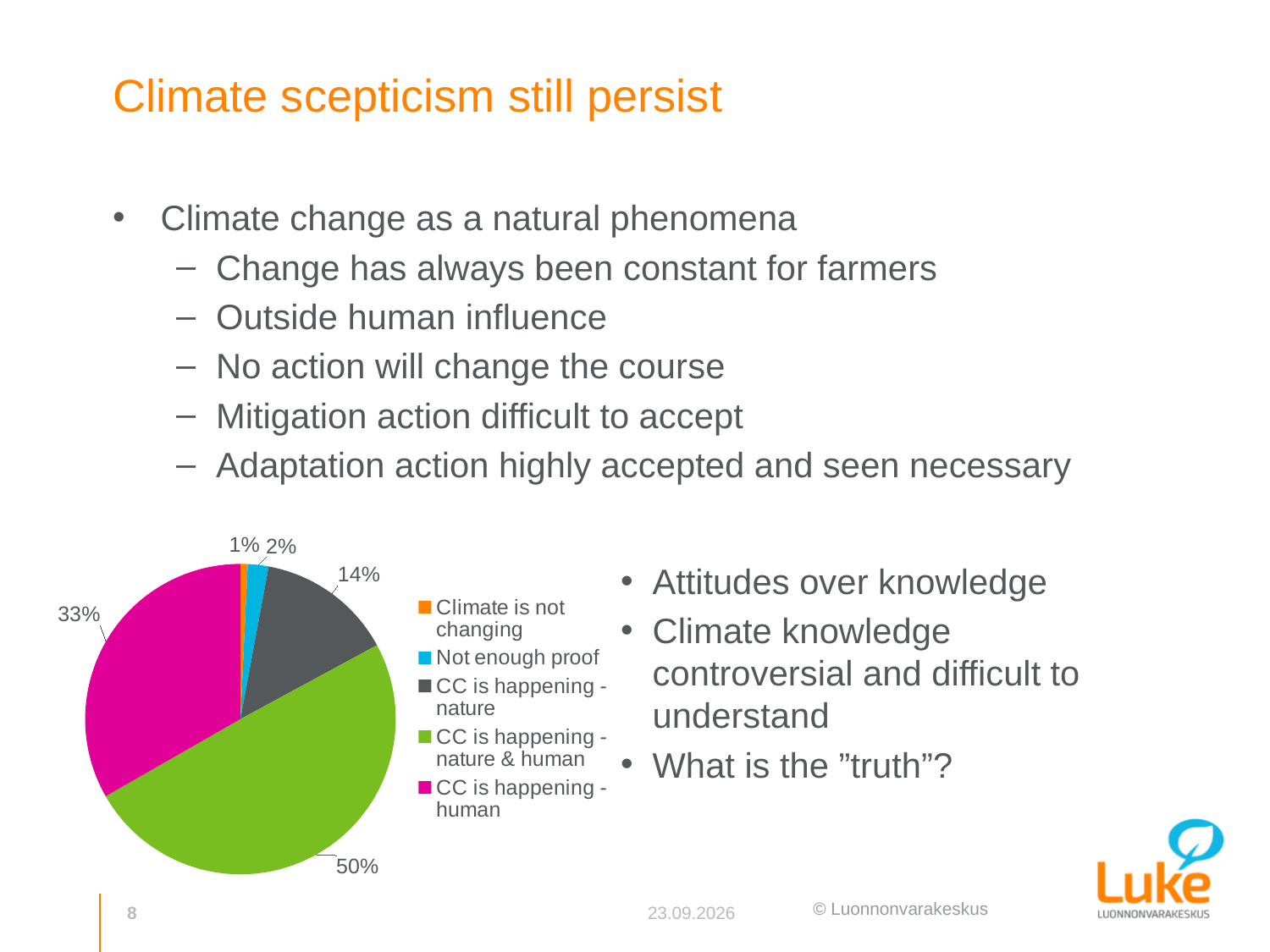
What percentage of the pie is 'CC is happening - human'? 33% What percentage of the pie is 'Climate is not changing'? 1% Which is larger: the share for 'CC is happening - nature' or the share for 'Not enough proof'? CC is happening - nature How many categories does the pie chart legend list? 5 What percentage of the pie is 'CC is happening - nature & human'? 50% What colour is the slice for 'CC is happening - human'? magenta What is the difference in percentage points between 'CC is happening - nature & human' and 'CC is happening - human'? 17 What type of chart is shown on the slide? pie chart Which category has the largest share of the pie? CC is happening - nature & human What percentage of the pie is 'CC is happening - nature'? 14% What percentage of the pie is 'Not enough proof'? 2% Which category has the smallest share of the pie? Climate is not changing